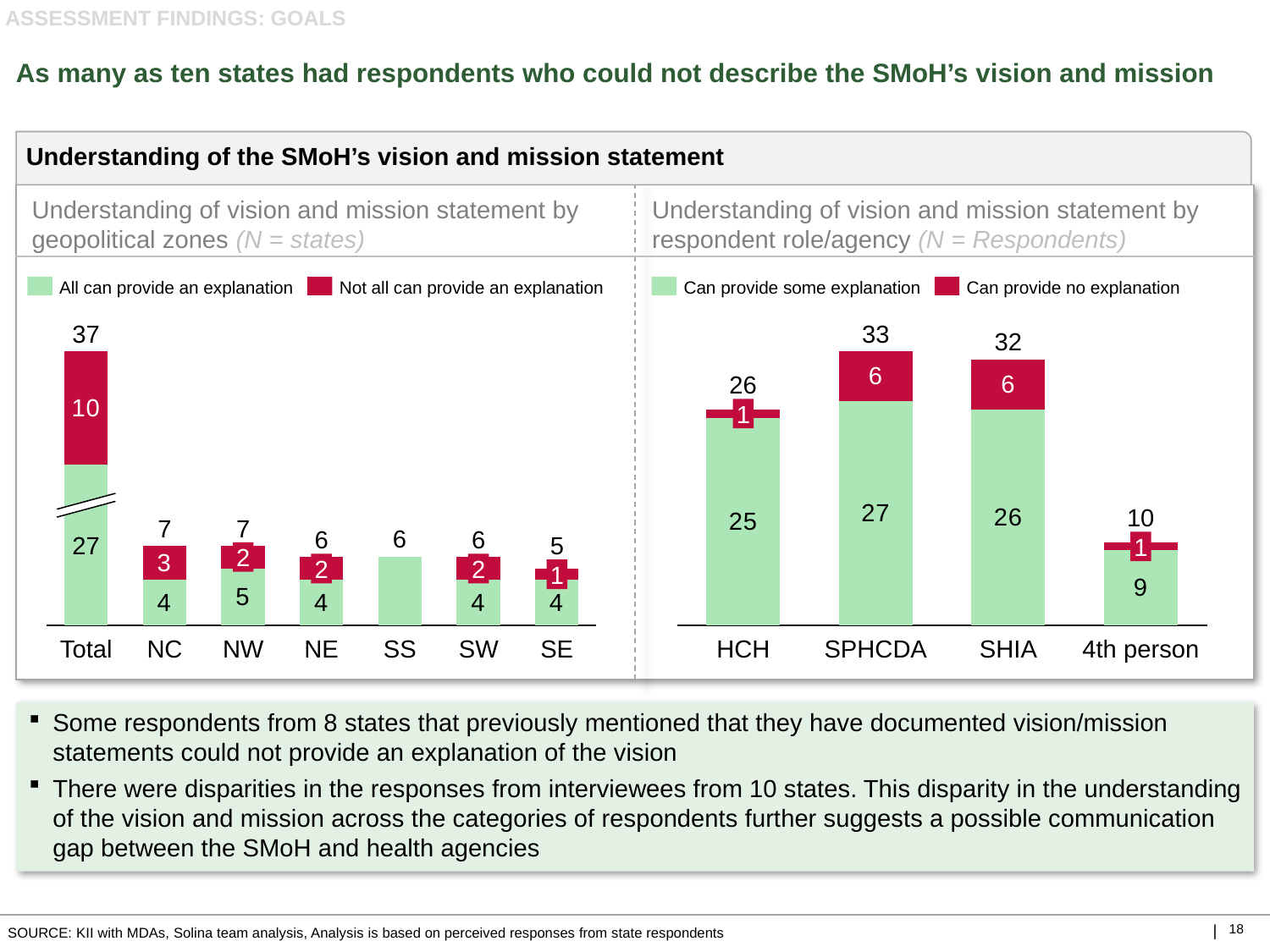
What type of chart is used in the chart by respondent role/agency? Stacked bar chart In the chart by respondent role/agency, which category has the highest total? SPHCDA In the chart by respondent role/agency, which is larger: the 'Can provide some explanation' value for SHIA or for HCH? SHIA In the chart by geopolitical zones, how many states in NC fall under 'Not all can provide an explanation'? 3 In the chart by geopolitical zones, which zone (excluding Total) has the lowest total? SE In the chart by geopolitical zones, what is the 'All can provide an explanation' value for NW? 5 In the chart by respondent role/agency, what is the total for SPHCDA? 33 In the chart by geopolitical zones, what is the difference between the 'Not all can provide an explanation' values for NC and SE? 2 In the chart by geopolitical zones, what is the total value for the Total bar? 37 In the chart by geopolitical zones, how many categories are shown on the x axis? 7 In the chart by respondent role/agency, how many HCH respondents can provide no explanation? 1 In the chart by respondent role/agency, how many series does the legend list? 2